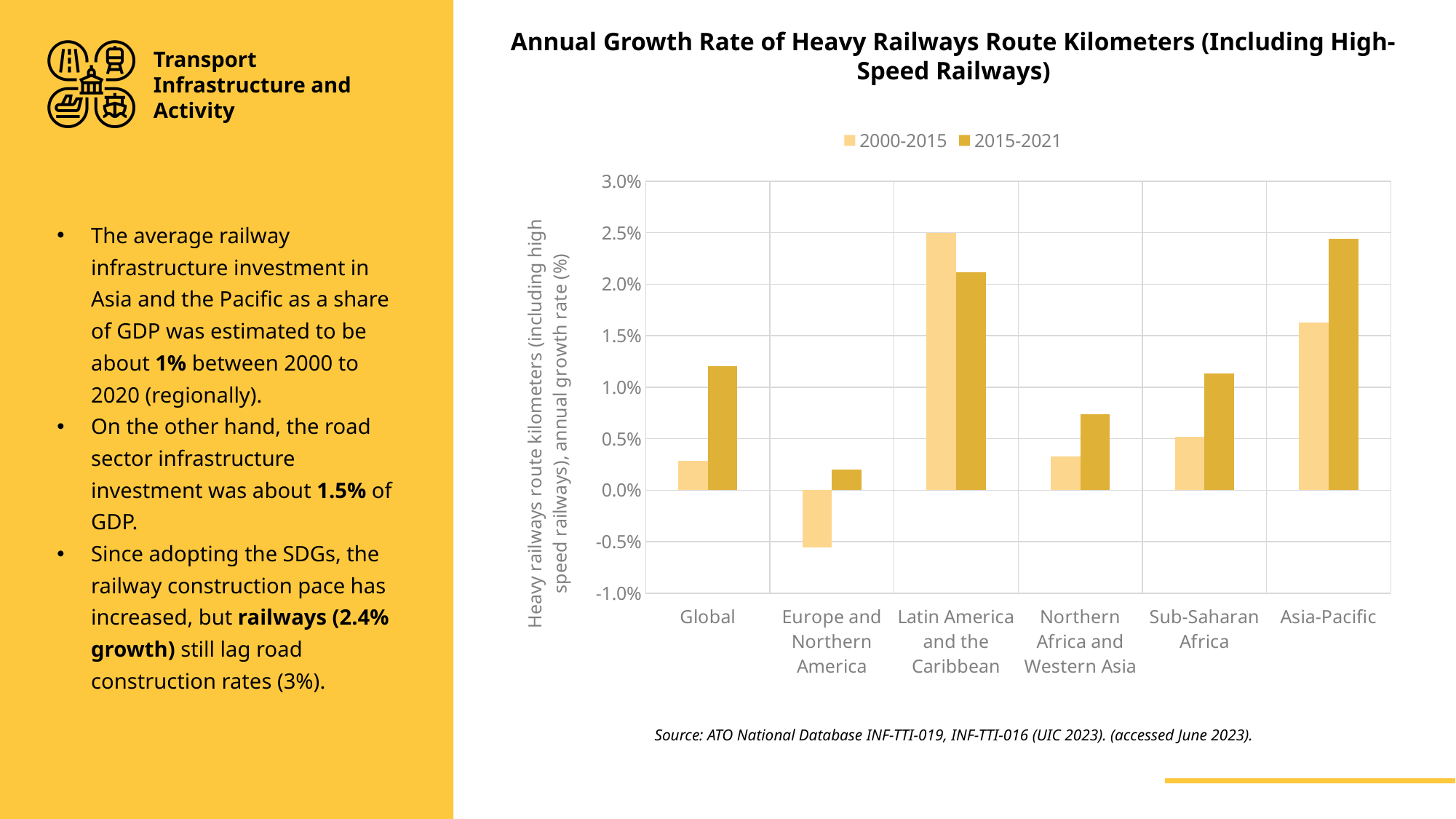
How many series does the legend list? 2 Which region has the highest 2000-2015 annual growth rate? Latin America and the Caribbean Is the 2015-2021 value for Asia-Pacific greater or less than 2.0%? greater For Sub-Saharan Africa, which period has the larger growth rate, 2000-2015 or 2015-2021? 2015-2021 What kind of chart is shown on the slide? bar chart Which region has the lowest 2000-2015 annual growth rate? Europe and Northern America Which region has the highest 2015-2021 annual growth rate? Asia-Pacific How many regions are shown on the x axis of the chart? 6 What are the two periods listed in the chart legend? 2000-2015 and 2015-2021 Is the 2000-2015 value for Europe and Northern America greater or less than 0.0%? less Is the 2015-2021 value for Global greater or less than 1.0%? greater For Latin America and the Caribbean, which period has the larger growth rate, 2000-2015 or 2015-2021? 2000-2015